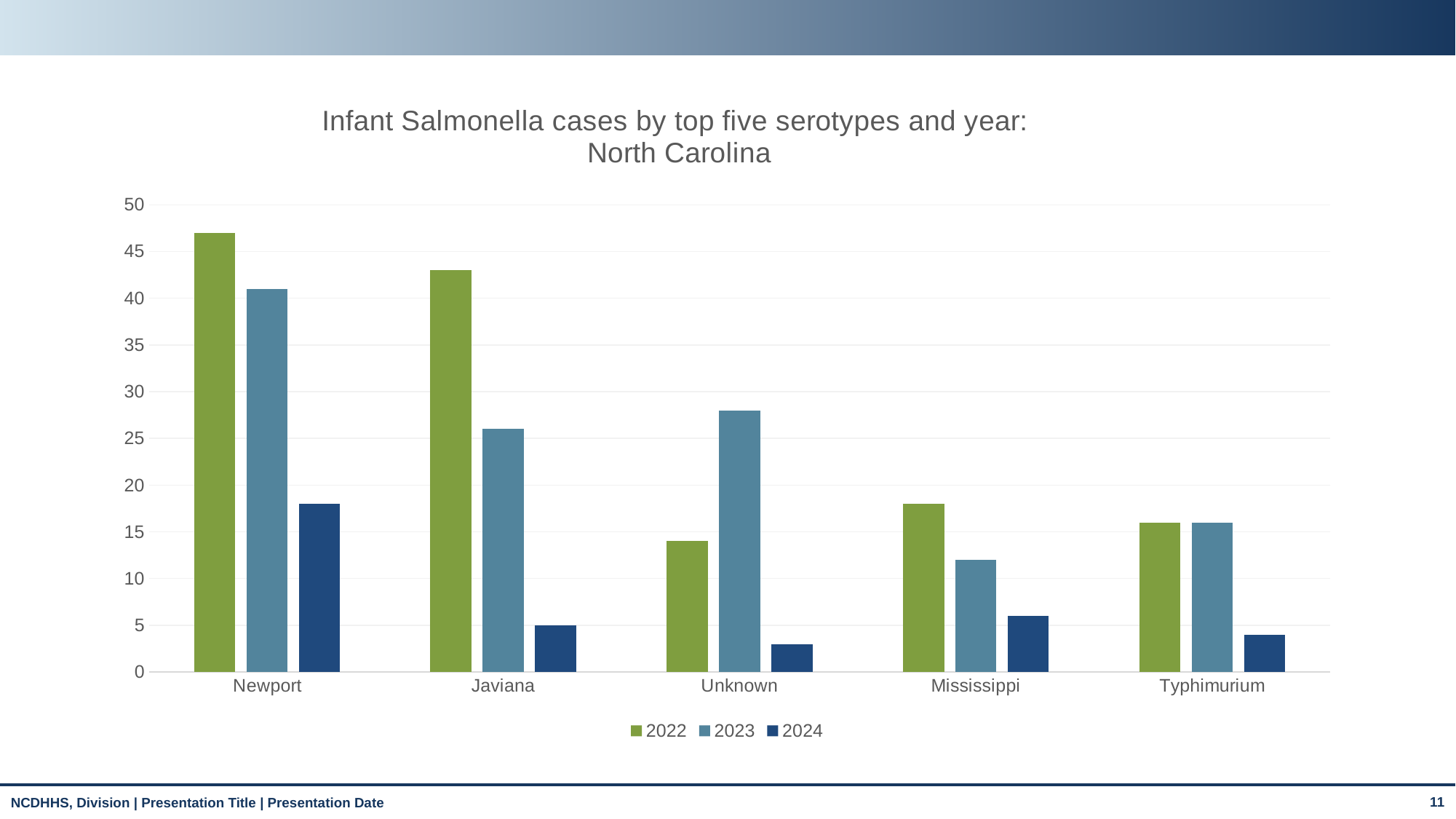
Is the value for Unknown in 2023 greater or less than 25? greater How many series does the legend list? 3 Is the value for Typhimurium in 2024 greater or less than 5? less What is the title of the chart? Infant Salmonella cases by top five serotypes and year: North Carolina What type of chart is shown on the slide? bar chart Is the value for Newport in 2022 greater or less than 45? greater Which serotype has the lowest value for 2022? Unknown Which serotype has the highest value for 2022? Newport For the Unknown serotype, which is larger: the 2022 value or the 2023 value? 2023 Which is larger: the 2022 value for Newport or the 2022 value for Javiana? Newport How many serotype categories are shown on the x axis? 5 Which serotype has the highest value for 2023? Newport